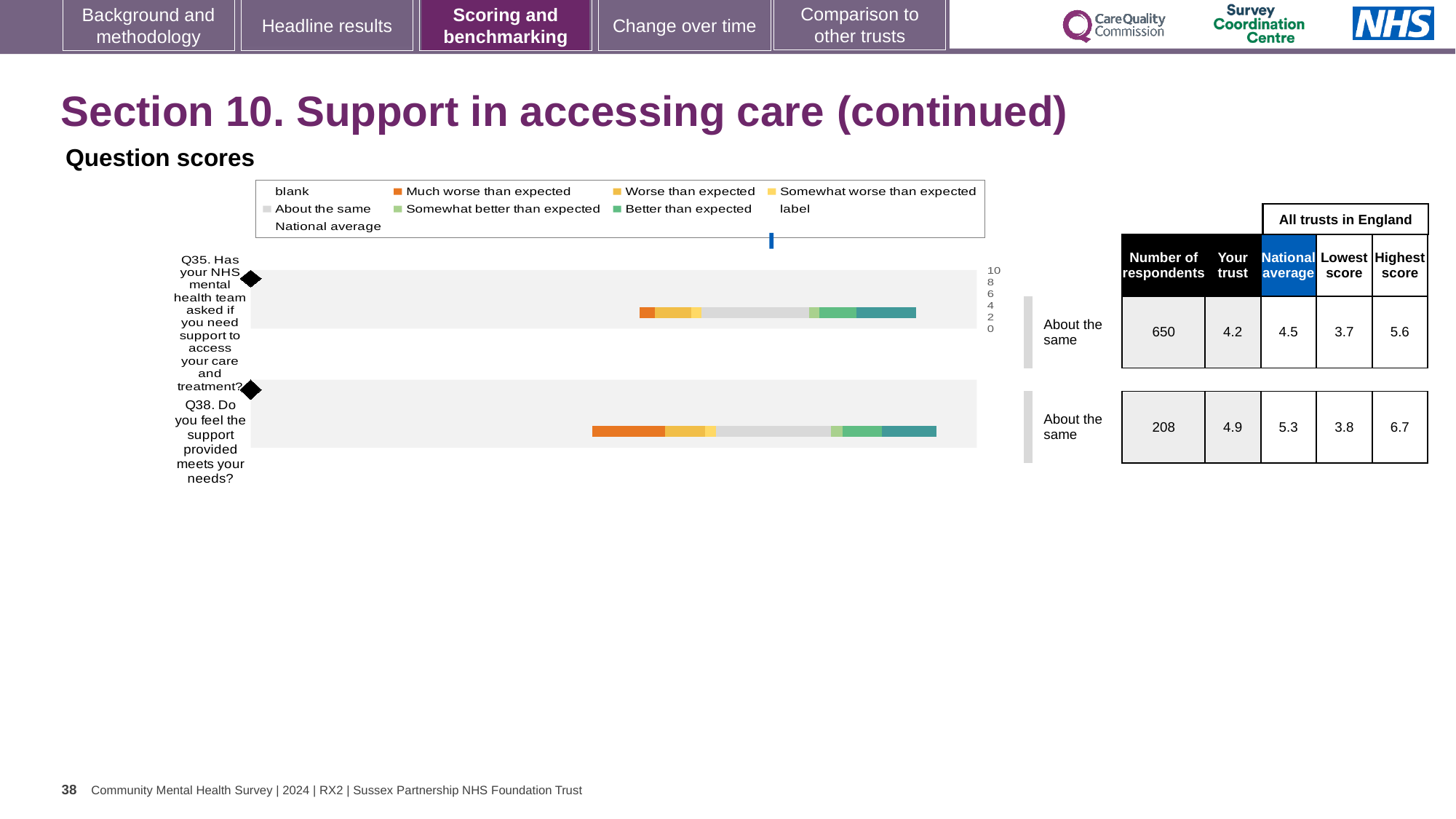
What is the lowest score among all trusts in England for Q38? 3.8 Which question has the higher 'Highest score' across all trusts in England? Q38 How many questions are plotted in the question scores chart? 2 How is the trust's result for Q35 categorised relative to expectations? About the same How many respondents answered Q35? 650 What is the heading above the chart on this slide? Question scores What kind of chart is used to show the question scores on this slide? Bar chart What is the difference between the highest and lowest scores for Q38? 2.9 What is the 'Your trust' score for Q35 (Has your NHS mental health team asked if you need support to access your care and treatment?)? 4.2 What is the national average score for Q38 (Do you feel the support provided meets your needs?)? 5.3 By how much is the national average higher than the trust's score for Q35? 0.3 Which question has the higher 'Your trust' score, Q35 or Q38? Q38